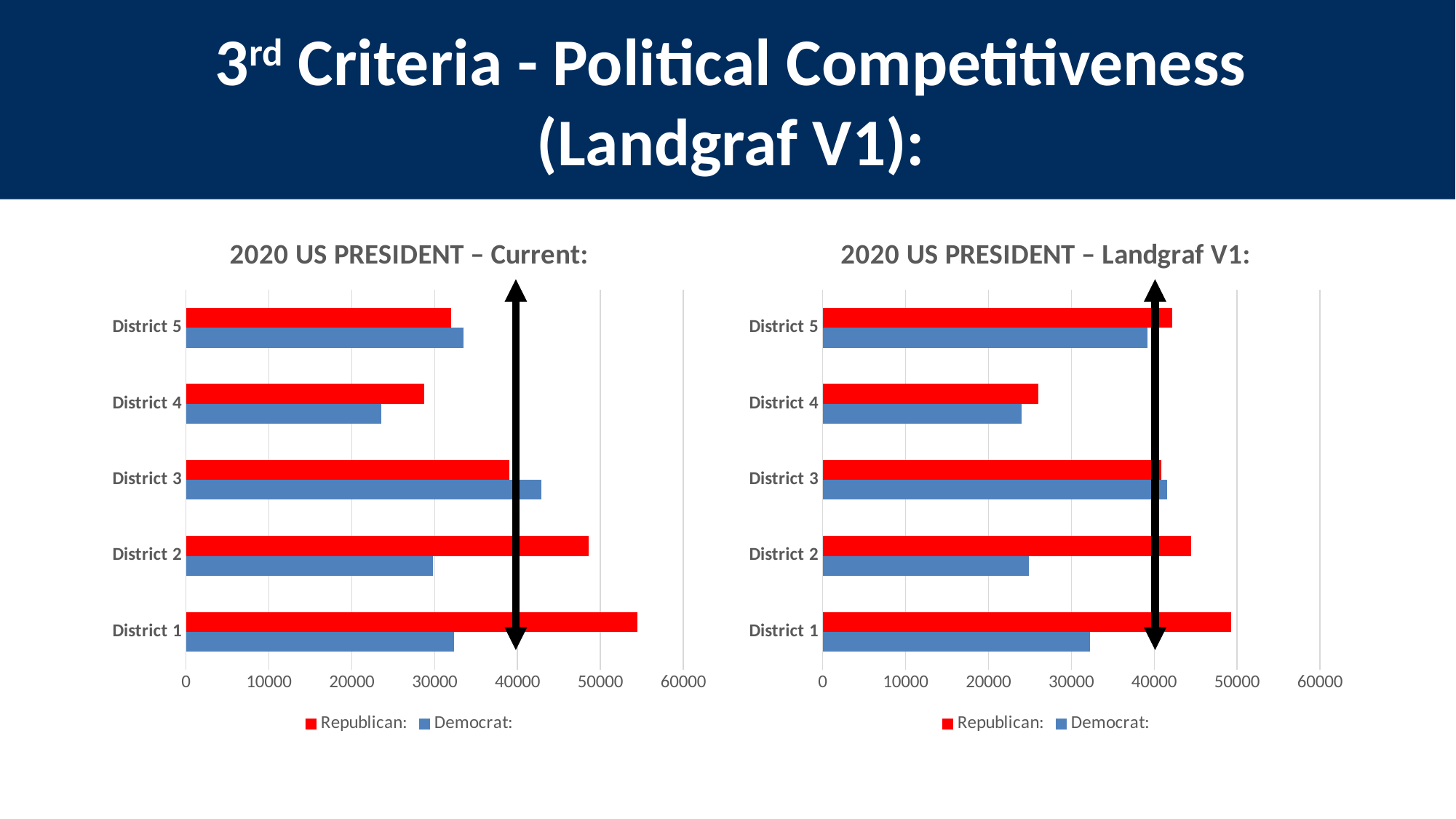
On the "2020 US PRESIDENT – Current:" chart, which district has the highest Republican value? District 1 How many districts are shown on the "2020 US PRESIDENT – Landgraf V1:" chart? 5 On the "2020 US PRESIDENT – Current:" chart, is the Democrat value for District 4 greater or less than 30000? less On the "2020 US PRESIDENT – Landgraf V1:" chart, is the Democrat value for District 2 greater or less than 30000? less On the "2020 US PRESIDENT – Current:" chart, which district has the lowest Democrat value? District 4 On the "2020 US PRESIDENT – Current:" chart, is the Republican value for District 1 greater or less than 50000? greater On the "2020 US PRESIDENT – Landgraf V1:" chart, which is larger for District 2, the Republican value or the Democrat value? Republican What kind of chart is the "2020 US PRESIDENT – Current:" chart? bar chart How many series does the legend of the "2020 US PRESIDENT – Current:" chart list? 2 What colour are the Democrat bars on the "2020 US PRESIDENT – Current:" chart? blue On the "2020 US PRESIDENT – Landgraf V1:" chart, which district has the lowest Republican value? District 4